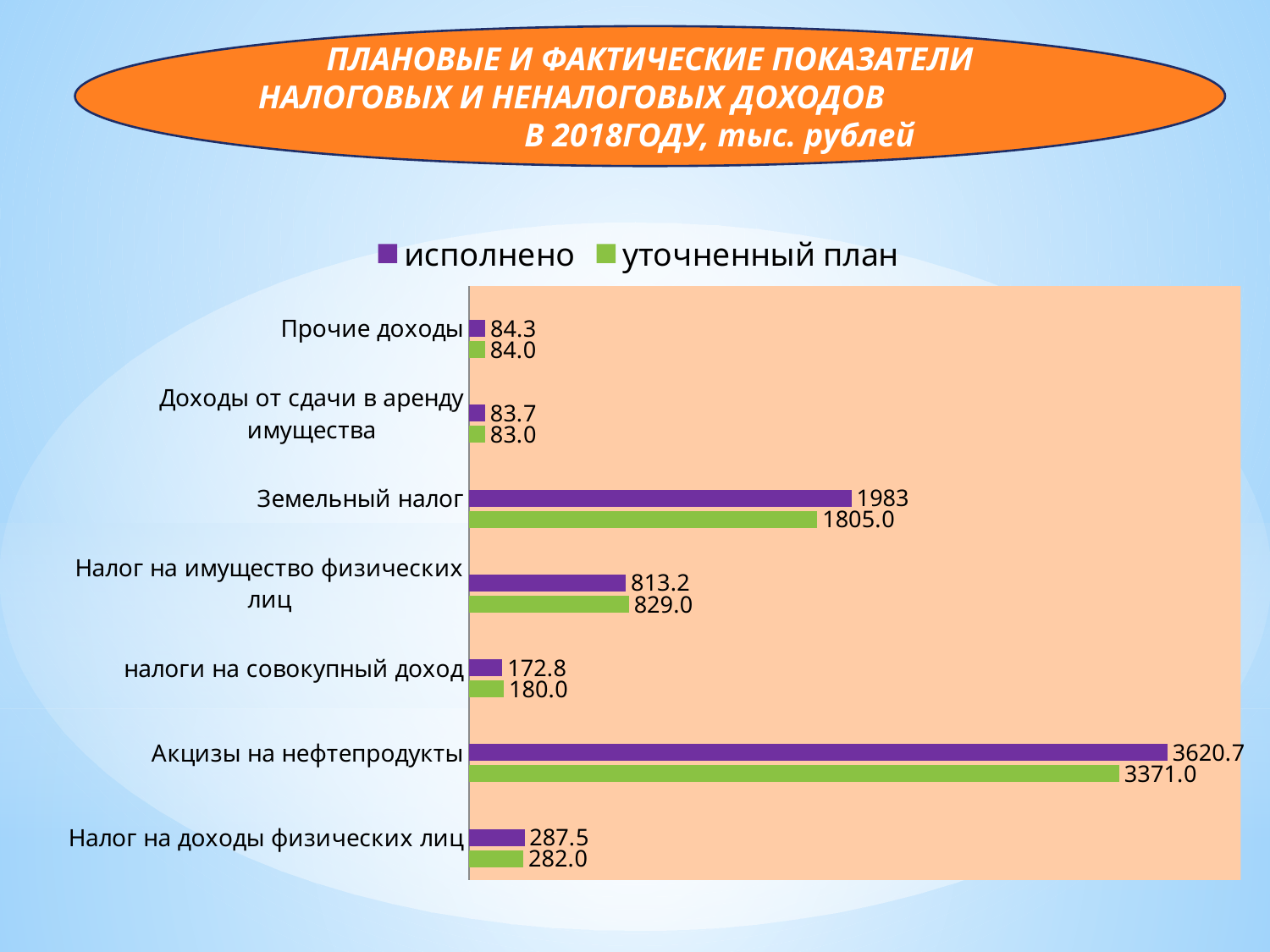
Which category has the lowest "уточненный план" value? Доходы от сдачи в аренду имущества Which category has the highest "исполнено" value? Акцизы на нефтепродукты How many series does the legend list? 2 What is the difference between "исполнено" and "уточненный план" for "Земельный налог"? 178 What is the difference between "исполнено" and "уточненный план" for "Акцизы на нефтепродукты"? 249.7 What type of chart is shown on the slide? bar chart What is the value of "уточненный план" for "Земельный налог"? 1805.0 For "налоги на совокупный доход", which is larger: "исполнено" or "уточненный план"? уточненный план What is the value of "исполнено" for "Акцизы на нефтепродукты"? 3620.7 How many categories are shown on the chart? 7 What is the value of "исполнено" for "Налог на имущество физических лиц"? 813.2 Which colour represents the "уточненный план" series? green